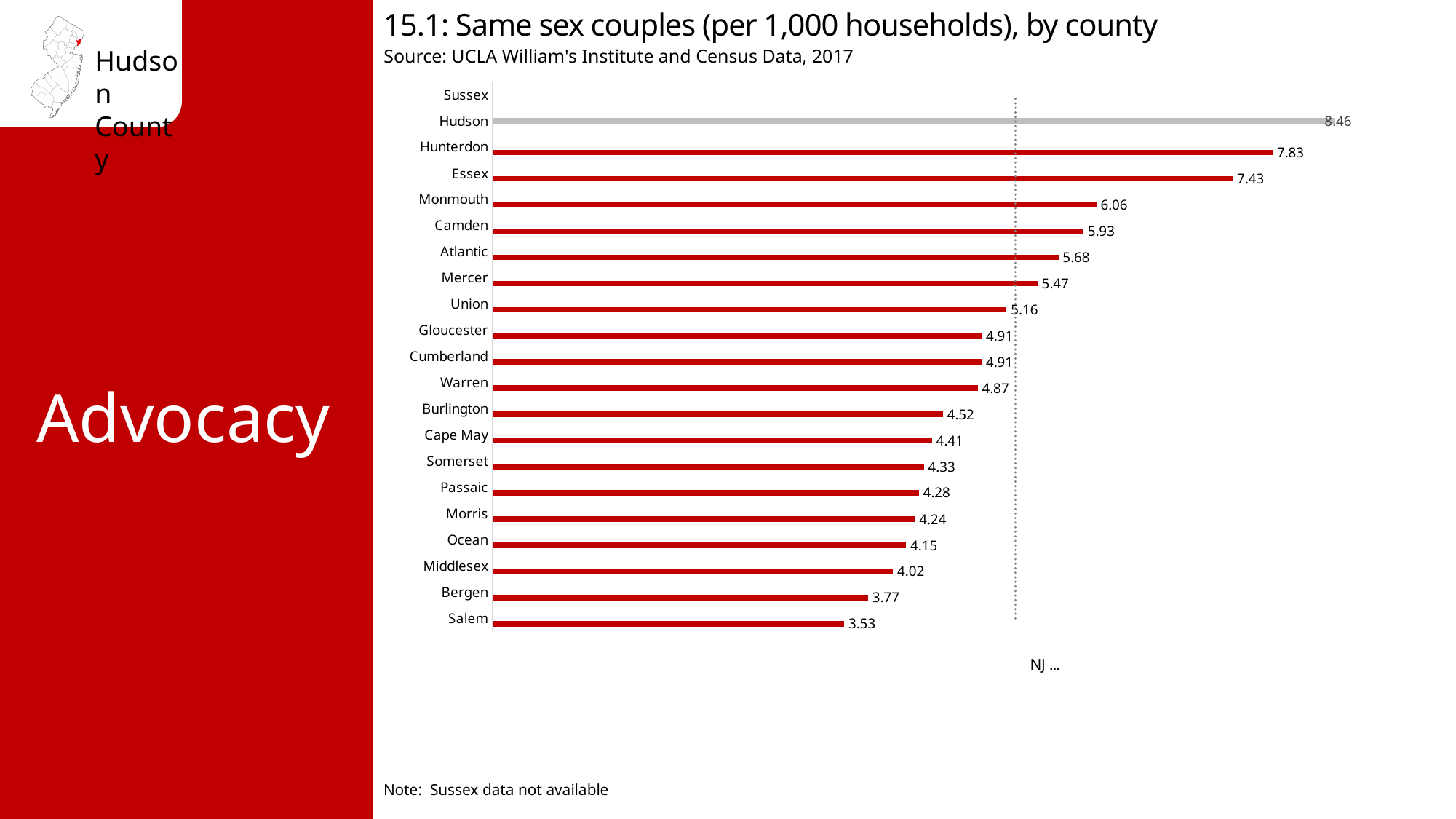
How many counties are listed on the vertical axis of the chart? 21 Which has a larger value, Essex or Monmouth? Essex Which county has the highest value in the chart? Hudson Which county has the lowest plotted value in the chart? Salem What is the difference between the values for Hudson and Salem? 4.93 What is the difference between the values for Hunterdon and Essex? 0.40 Which county's bar is coloured grey instead of red? Hudson What kind of chart is shown on the slide? Bar chart What is the value for Hudson in the chart? 8.46 What is the value for Bergen in the chart? 3.77 What is the value for Monmouth in the chart? 6.06 What is the value for Cape May in the chart? 4.41